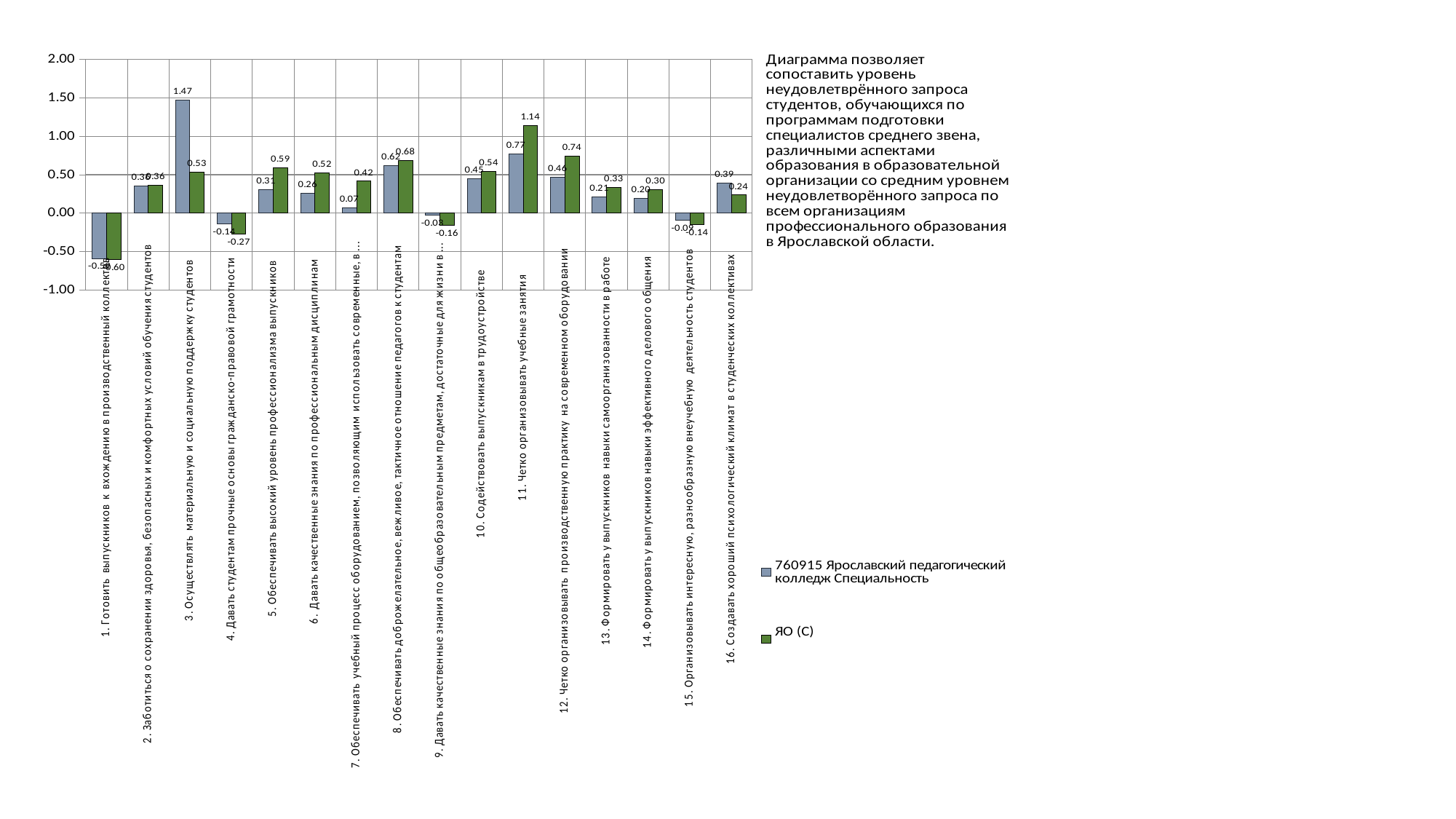
What is the value for the series "760915 Ярославский педагогический колледж Специальность" in category "3. Осуществлять материальную и социальную поддержку студентов"? 1.47 What kind of chart is shown on the slide? bar chart How many categories are plotted along the x axis? 16 How many series does the legend list? 2 In category "16. Создавать хороший психологический климат в студенческих коллективах", which series has the larger value? 760915 Ярославский педагогический колледж Специальность What is the difference between the two series in category "3. Осуществлять материальную и социальную поддержку студентов" (1.47 minus 0.53)? 0.94 What colour are the bars for the series "ЯО (С)"? green In which category does the series "760915 Ярославский педагогический колледж Специальность" reach its highest value? 3. Осуществлять материальную и социальную поддержку студентов Is the value for "ЯО (С)" in category "11. Четко организовывать учебные занятия" greater or less than 1.00? greater What is the value for the series "ЯО (С)" in category "11. Четко организовывать учебные занятия"? 1.14 In which category does the series "ЯО (С)" have its lowest value? 1. Готовить выпускников к вхождению в производственный коллектив What is the value for the series "ЯО (С)" in category "4. Давать студентам прочные основы гражданско-правовой грамотности"? -0.27